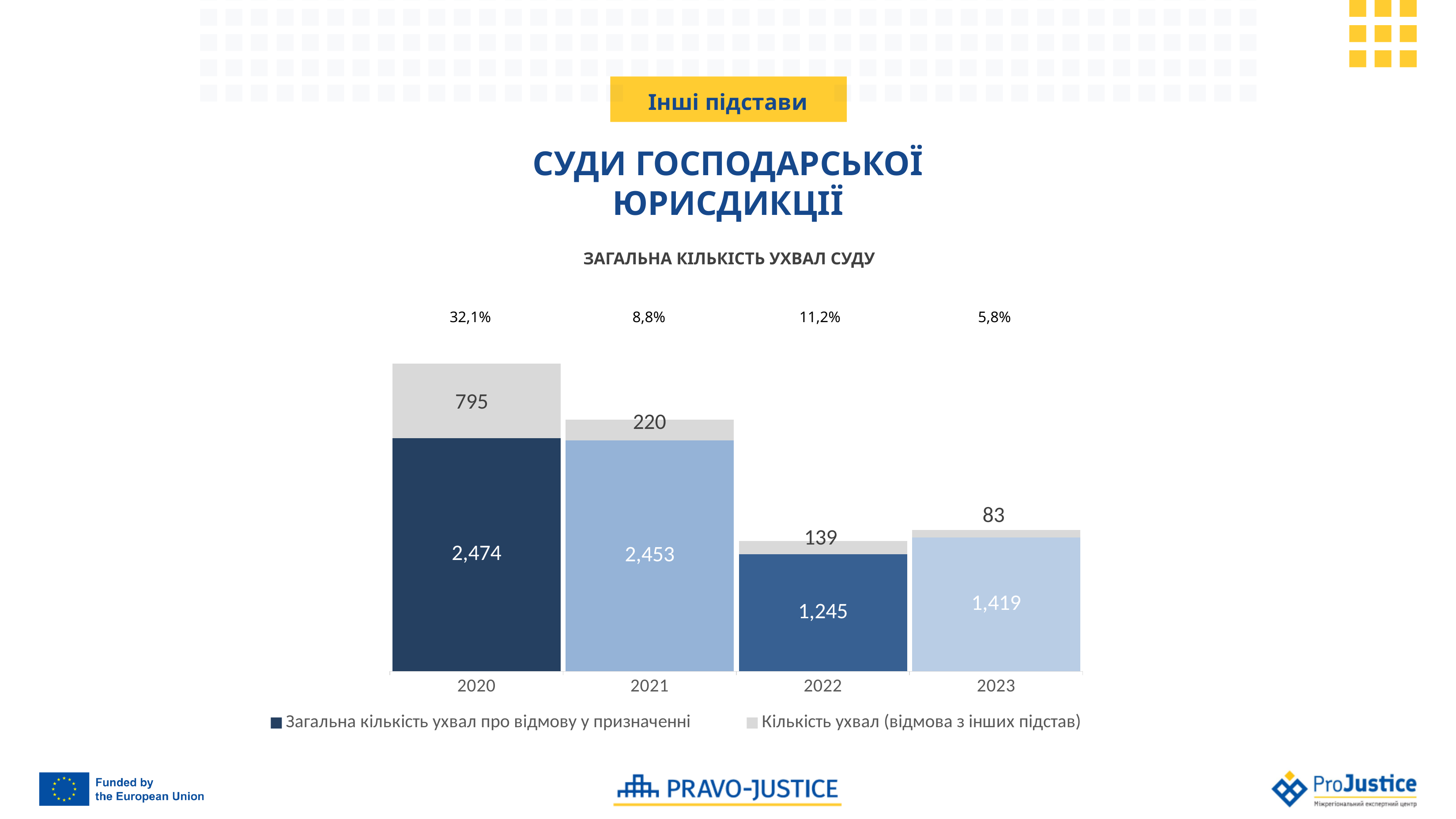
What type of chart is shown on the slide? Stacked bar chart Which year has the lowest value for 'Загальна кількість ухвал про відмову у призначенні'? 2022 What percentage is shown above the bar for 2022? 11,2% How many series does the legend list? 2 What is the difference between the 'Загальна кількість ухвал про відмову у призначенні' values for 2020 and 2021? 21 What is the value of 'Кількість ухвал (відмова з інших підстав)' for 2023? 83 What is the value of 'Кількість ухвал (відмова з інших підстав)' for 2021? 220 Which year has the highest value for 'Кількість ухвал (відмова з інших підстав)'? 2020 How many years are shown on the x axis? 4 What is the value of 'Загальна кількість ухвал про відмову у призначенні' for 2020? 2,474 Which is larger: the 'Загальна кількість ухвал про відмову у призначенні' value for 2022 or for 2023? 2023 What is the total of the stacked bar for 2020? 3,269